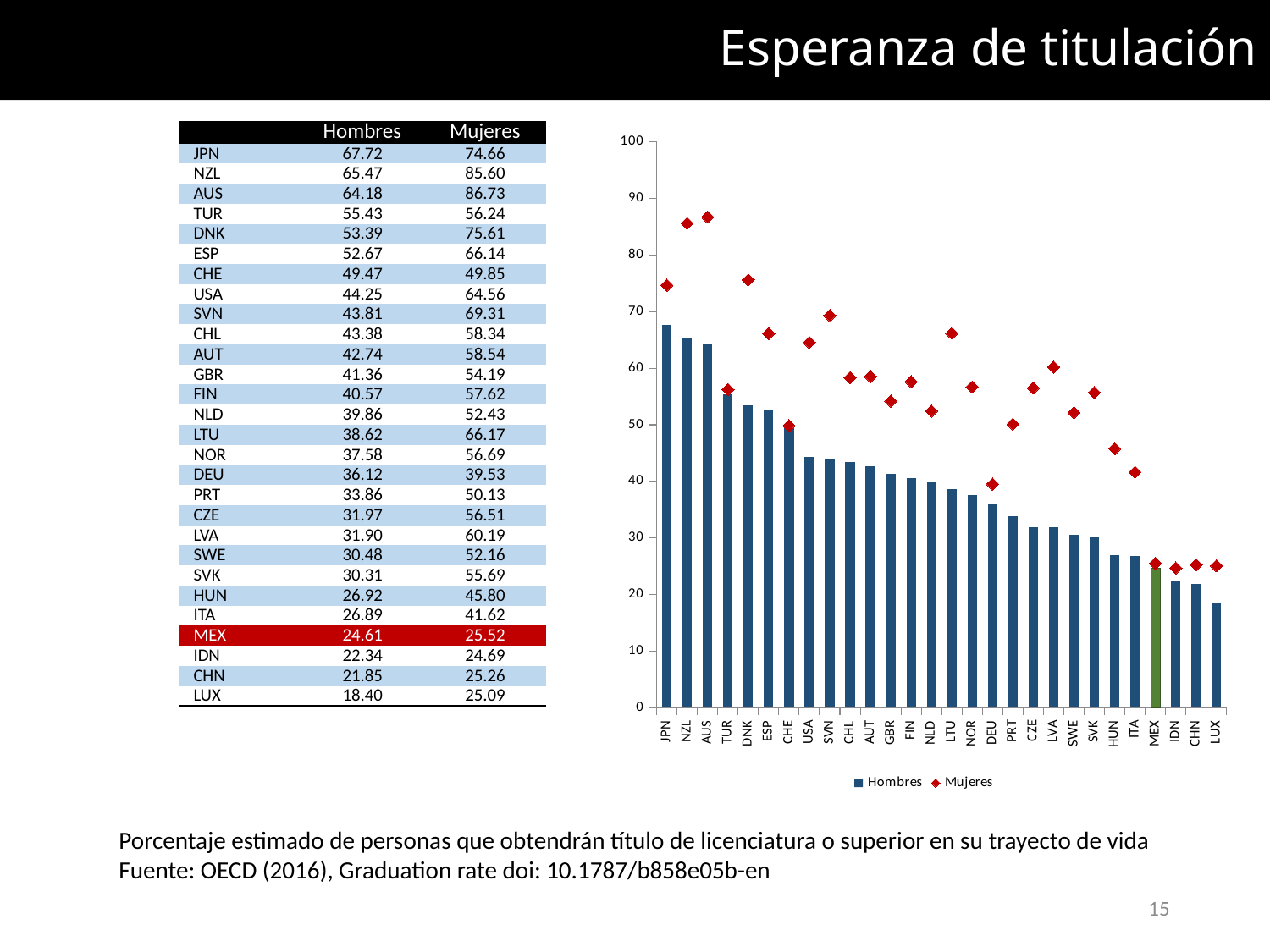
Which country has the highest value for Hombres? JPN What is the Hombres value for MEX? 24.61 What is the difference between the Mujeres and Hombres values for AUS? 22.55 Do the Hombres bars rise or fall from left to right along the x axis? fall How many series does the chart legend list? 2 Which country has the highest value for Mujeres? AUS Which country has the lowest value for Hombres? LUX Which is larger for LTU, the Hombres value or the Mujeres value? Mujeres Is the Hombres value for DNK greater or less than 50? greater What kind of chart is shown on the slide? bar chart with markers (combination chart) What is the Mujeres value for NZL? 85.60 How many countries are plotted along the x axis of the chart? 28